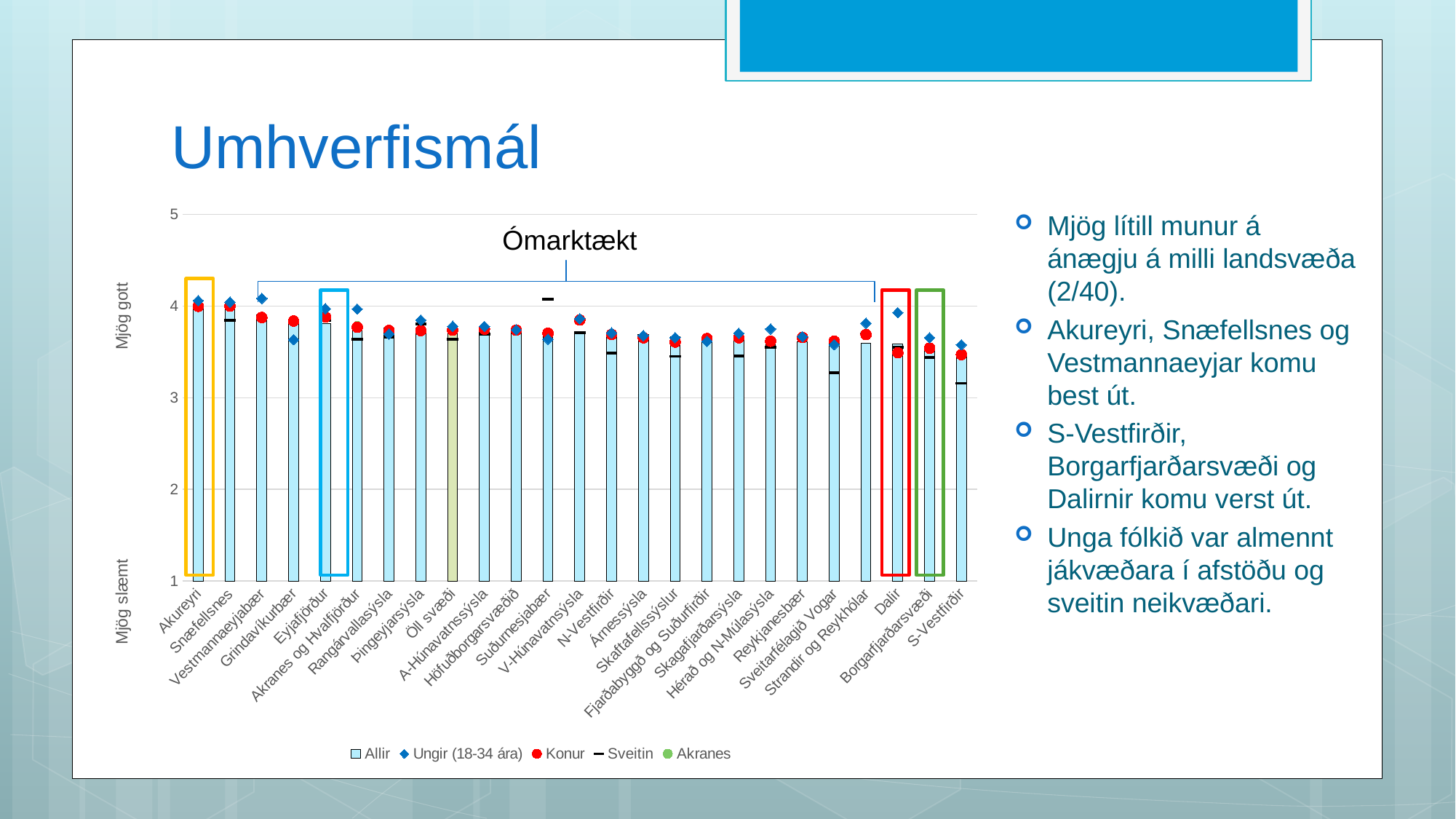
Is the 'Allir' value for Dalir greater or less than 4? less Do the 'Allir' bar values generally rise or fall from left to right along the x axis? fall What is the title of the slide containing the chart? Umhverfismál Which has the larger 'Allir' value, Akureyri or S-Vestfirðir? Akureyri How many regions (categories) are shown along the x axis of the chart? 25 Which region has the lowest 'Allir' bar in the chart? S-Vestfirðir What word is written in the annotation above the bracket spanning the middle of the chart? Ómarktækt What kind of chart is shown on the slide? Bar chart Is the 'Allir' value for Sveitarfélagið Vogar greater or less than 3? greater Is the 'Allir' value for Borgarfjarðarsvæði greater or less than 4? less How many series does the chart legend list? 5